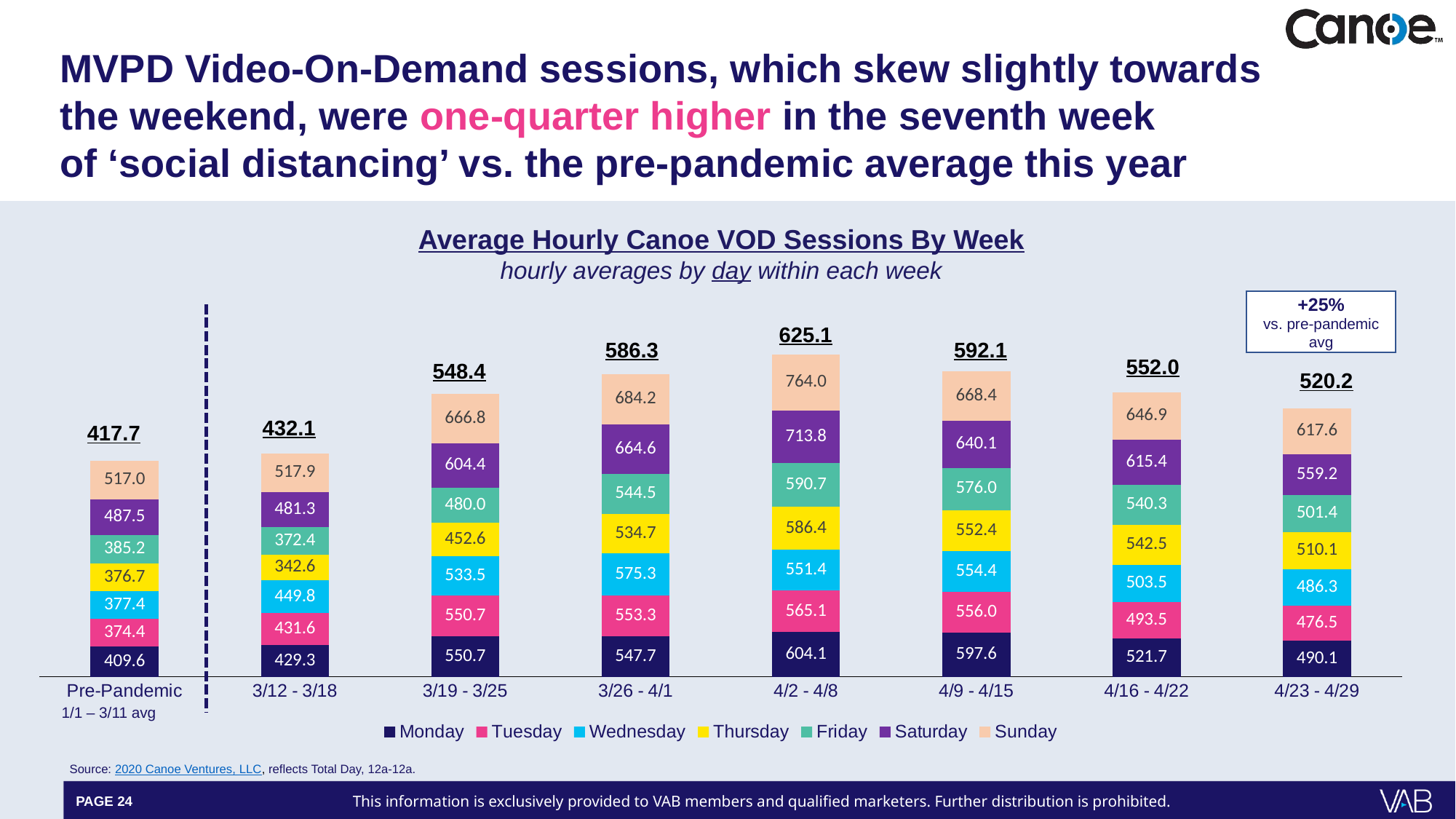
How many bars (weeks, including Pre-Pandemic) are shown on the chart? 8 What percentage change vs. the pre-pandemic average is shown in the callout box? +25% Do the weekly average figures above the bars rise or fall from 3/12 - 3/18 to 4/2 - 4/8? Rise What is the Monday value for the week 4/2 - 4/8? 604.1 How many series does the legend list? 7 What kind of chart is shown on the slide? Stacked bar chart In the week 3/19 - 3/25, which is larger: the Saturday value or the Friday value? Saturday Which week has the highest weekly average figure shown above its bar? 4/2 - 4/8 What is the weekly average figure shown above the 4/23 - 4/29 bar? 520.2 Which bar has the lowest weekly average figure shown above it? Pre-Pandemic What is the Sunday value for the Pre-Pandemic bar? 517.0 What is the difference between the Sunday value for 4/2 - 4/8 and the Sunday value for Pre-Pandemic? 247.0